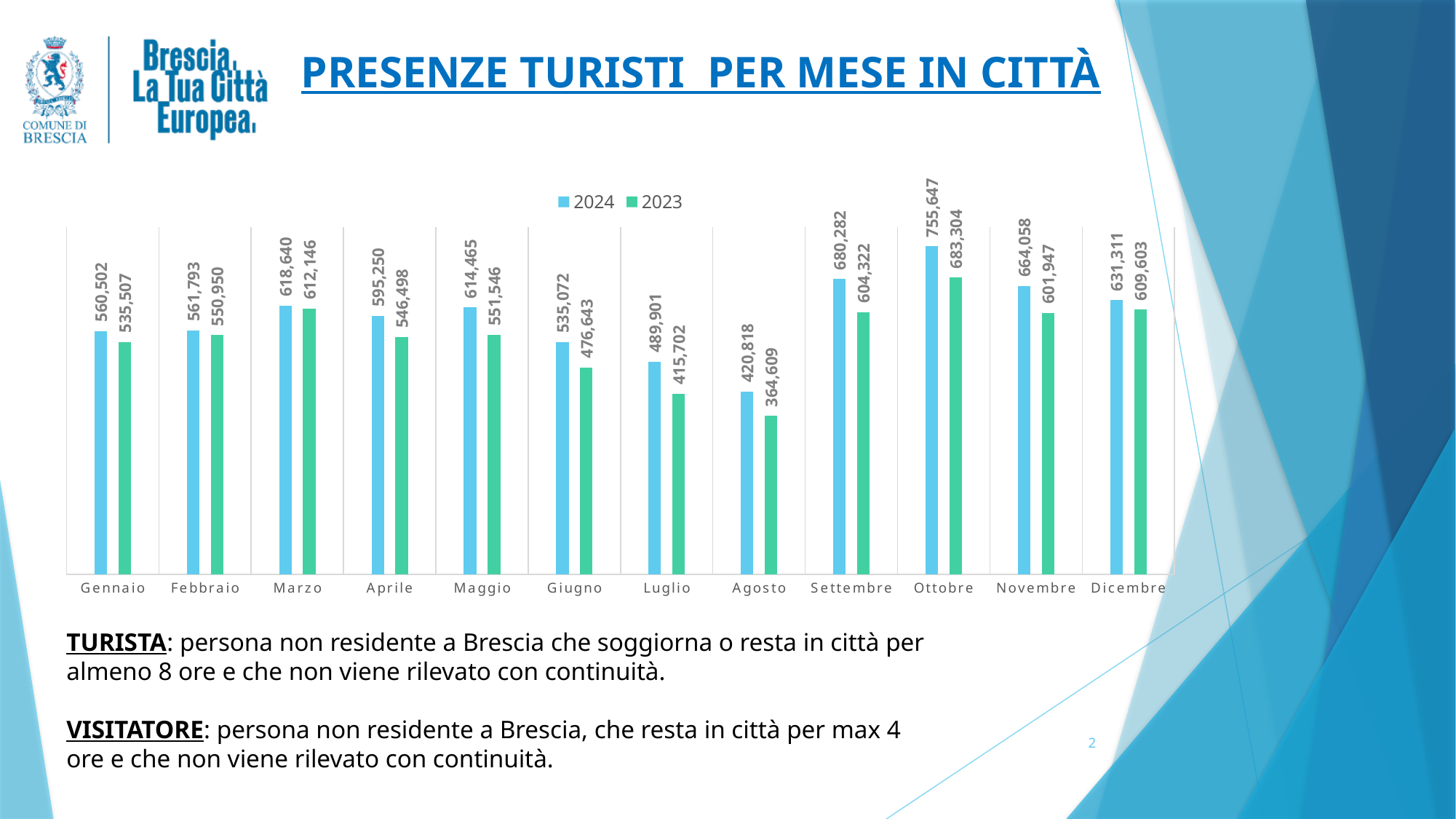
How many months are shown on the x axis? 12 What is the difference between the 2024 and 2023 values for Ottobre? 72,343 What type of chart is shown on the slide? Bar chart For Gennaio, which is larger: the 2024 value or the 2023 value? 2024 What is the 2024 value for Ottobre? 755,647 What is the 2023 value for Agosto? 364,609 How many series does the legend list? 2 What is the difference between the 2024 and 2023 values for Agosto? 56,209 What is the 2024 value for Luglio? 489,901 Do the 2024 values rise or fall from Maggio to Agosto? Fall Which month has the lowest 2023 value? Agosto Which month has the highest 2024 value? Ottobre